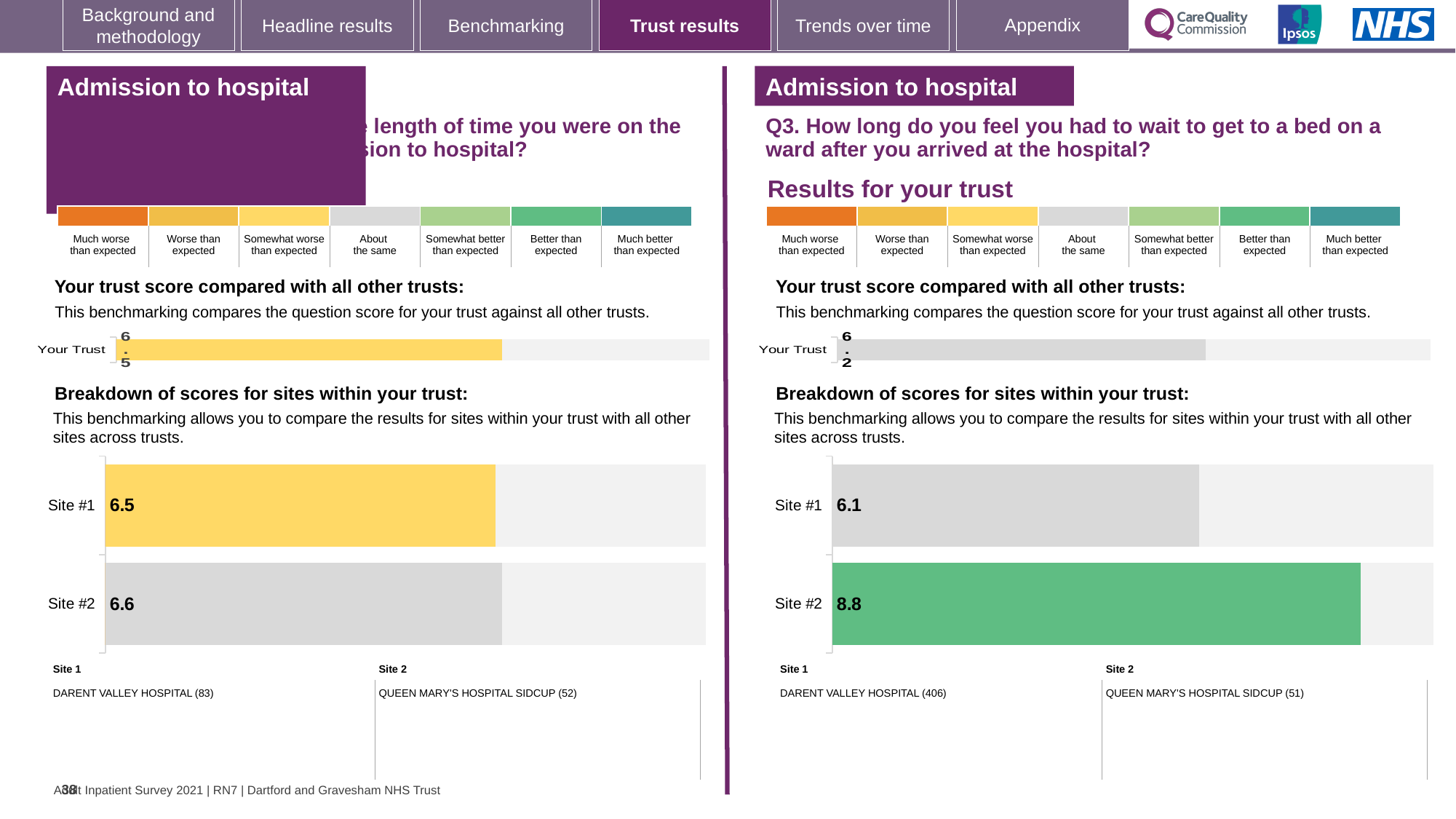
On the right-hand Q3 site breakdown chart, what colour is the Site #2 bar? Green What type of chart is used for the site breakdown on the right-hand side of the slide? Bar chart On the left-hand site breakdown chart, what is the difference between the Site #2 and Site #1 scores? 0.1 On the left-hand 'Your trust score compared with all other trusts' bar, what is the score for Your Trust? 6.5 On the right-hand Q3 site breakdown chart, what is the difference between the Site #2 and Site #1 scores? 2.7 On the right-hand chart for Q3 (wait to get to a bed on a ward), what is the score for Site #1? 6.1 On the right-hand chart for Q3 (wait to get to a bed on a ward), what is the score for Site #2? 8.8 On the right-hand Q3 site breakdown chart, which site has the higher score? Site #2 How many sites are shown in the right-hand Q3 site breakdown chart? 2 On the left-hand site breakdown chart, what is the score for Site #1? 6.5 On the left-hand site breakdown chart, what is the score for Site #2? 6.6 On the right-hand Q3 'Your trust score compared with all other trusts' bar, what is the score for Your Trust? 6.2